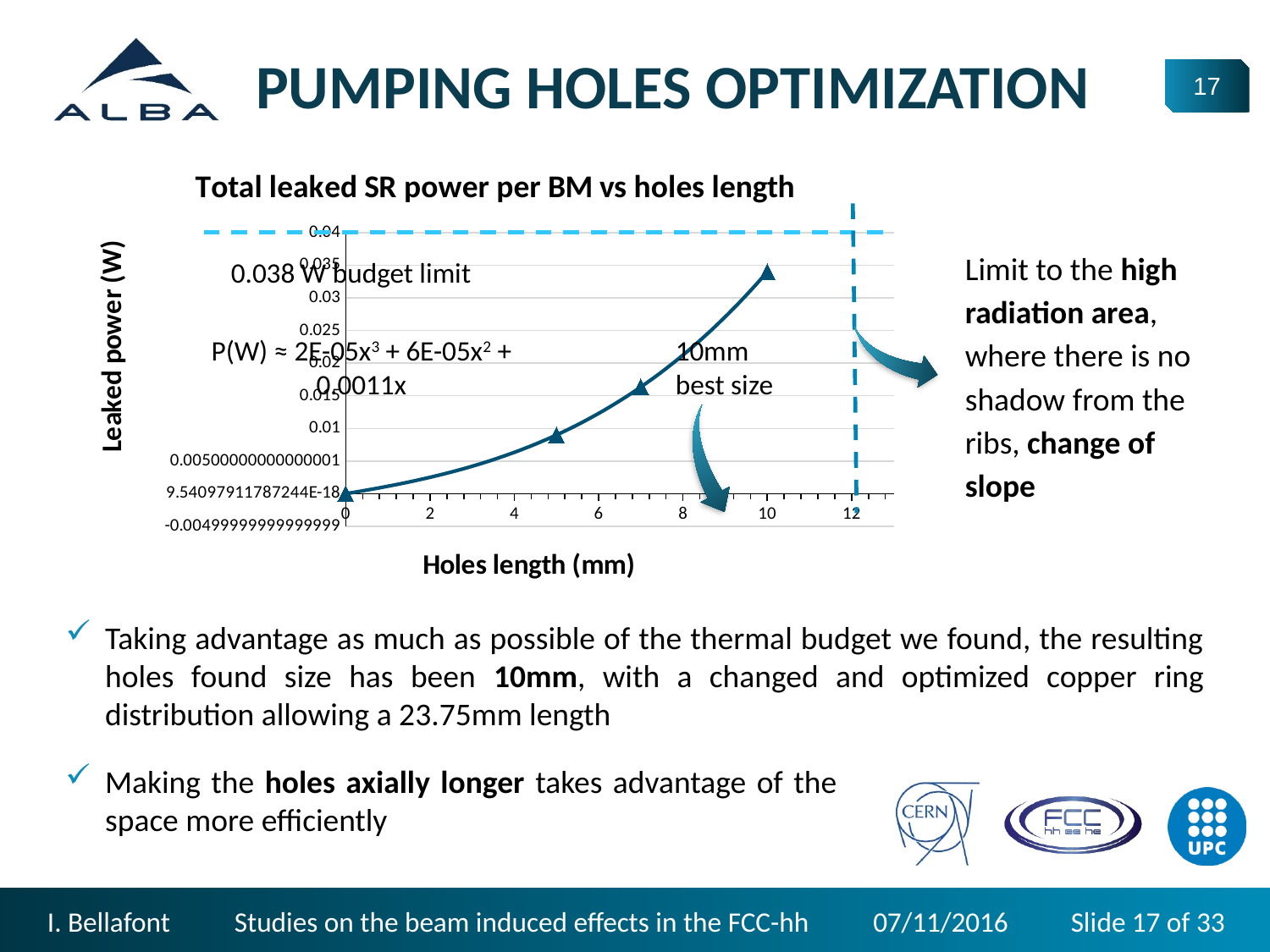
Does the leaked power rise or fall as the holes length increases? rise Is the leaked power at a holes length of 10 mm greater or less than 0.04? less What kind of chart is shown on the slide? line chart How many data points are plotted on the chart? 4 What is the label of the x axis of the chart? Holes length (mm) What is the title of the chart? Total leaked SR power per BM vs holes length Is the leaked power at a holes length of 7 mm greater or less than 0.02? less At which holes length is the leaked power highest? 10 Is the leaked power at a holes length of 10 mm greater or less than 0.03? greater Which has the larger leaked power: a holes length of 5 mm or 7 mm? 7 mm At which holes length is the leaked power lowest? 0